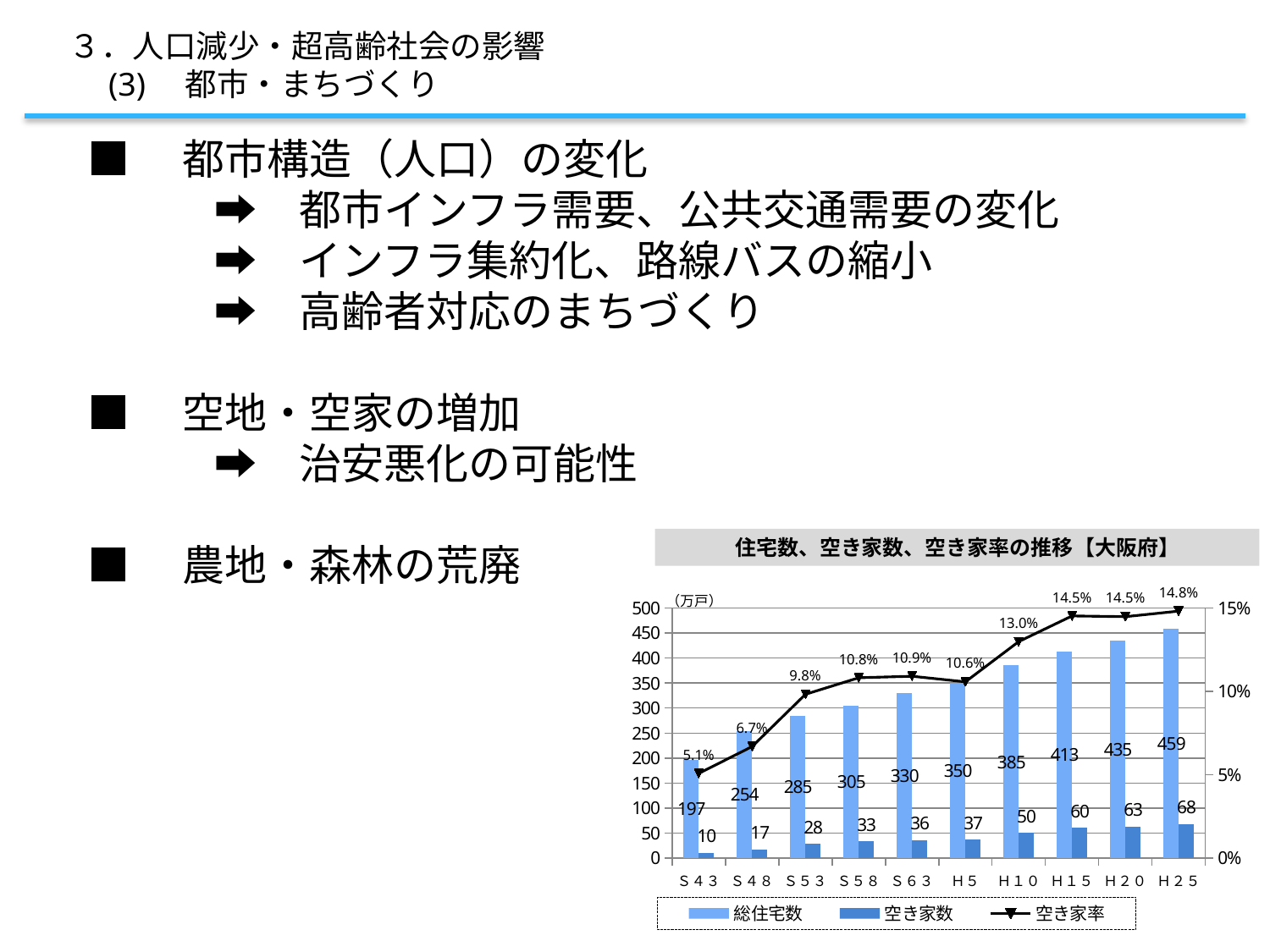
What is the title of the chart? 住宅数、空き家数、空き家率の推移【大阪府】 What is the 空き家率 for H10? 13.0% What is the value of 総住宅数 for H25? 459 What is the difference in 総住宅数 between H25 and S43? 262 What is the value of 空き家数 for S53? 28 Does 総住宅数 rise or fall from S43 to H25? Rise Which category has the highest 空き家数? H25 How many categories are shown on the x axis? 10 Which category has the lowest 総住宅数? S43 Which is larger, the 空き家率 for S63 or for H5? S63 What kind of chart is this? Combined bar and line chart How many series does the legend list? 3